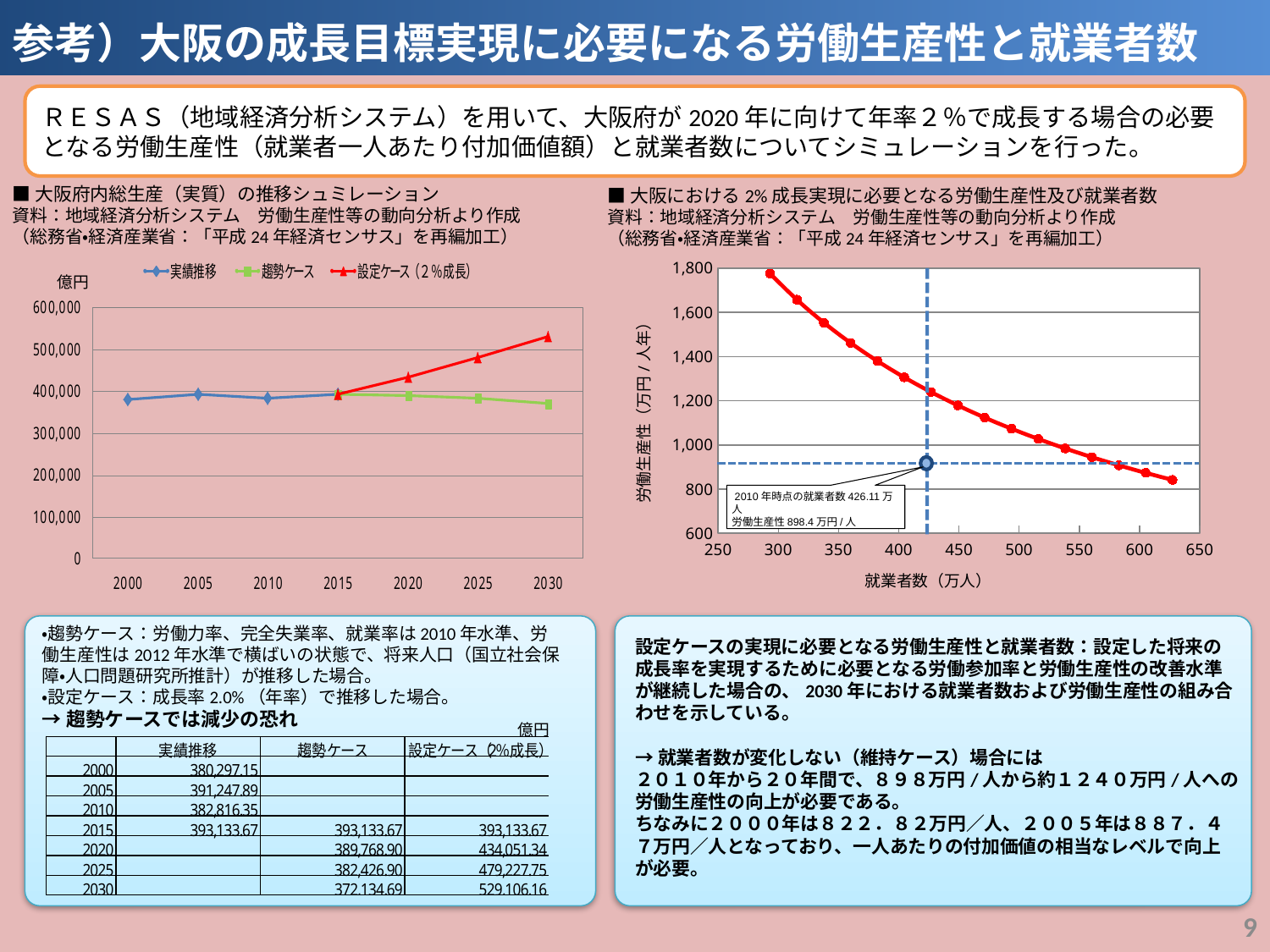
On the left chart (大阪府内総生産の推移シュミレーション), what unit is shown on the y axis? 億円 On the left chart (大阪府内総生産の推移シュミレーション), how many series does the legend list? 3 On the left chart (大阪府内総生産の推移シュミレーション), what is the value of 実績推移 in 2000? 380,297.15 On the right chart (大阪における2%成長実現に必要となる労働生産性及び就業者数), what is the labor productivity at the 2010 point marked on the chart? 898.4万円/人 On the left chart (大阪府内総生産の推移シュミレーション), what is the difference between 設定ケース (2%成長) and 趨勢ケース in 2030? 156,971.47 On the left chart (大阪府内総生産の推移シュミレーション), which is larger in 2020: 設定ケース (2%成長) or 趨勢ケース? 設定ケース (2%成長) On the left chart (大阪府内総生産の推移シュミレーション), what is the value of 趨勢ケース in 2030? 372,134.69 On the left chart (大阪府内総生産の推移シュミレーション), is the value of 設定ケース (2%成長) in 2030 greater or less than 500,000? greater On the right chart (大阪における2%成長実現に必要となる労働生産性及び就業者数), what is the number of employees at the 2010 point marked on the chart? 426.11万人 On the left chart (大阪府内総生産の推移シュミレーション), what type of chart is it? line chart On the left chart (大阪府内総生産の推移シュミレーション), does the 趨勢ケース series rise or fall from 2015 to 2030? fall On the left chart (大阪府内総生産の推移シュミレーション), what is the value of 設定ケース (2%成長) in 2030? 529,106.16